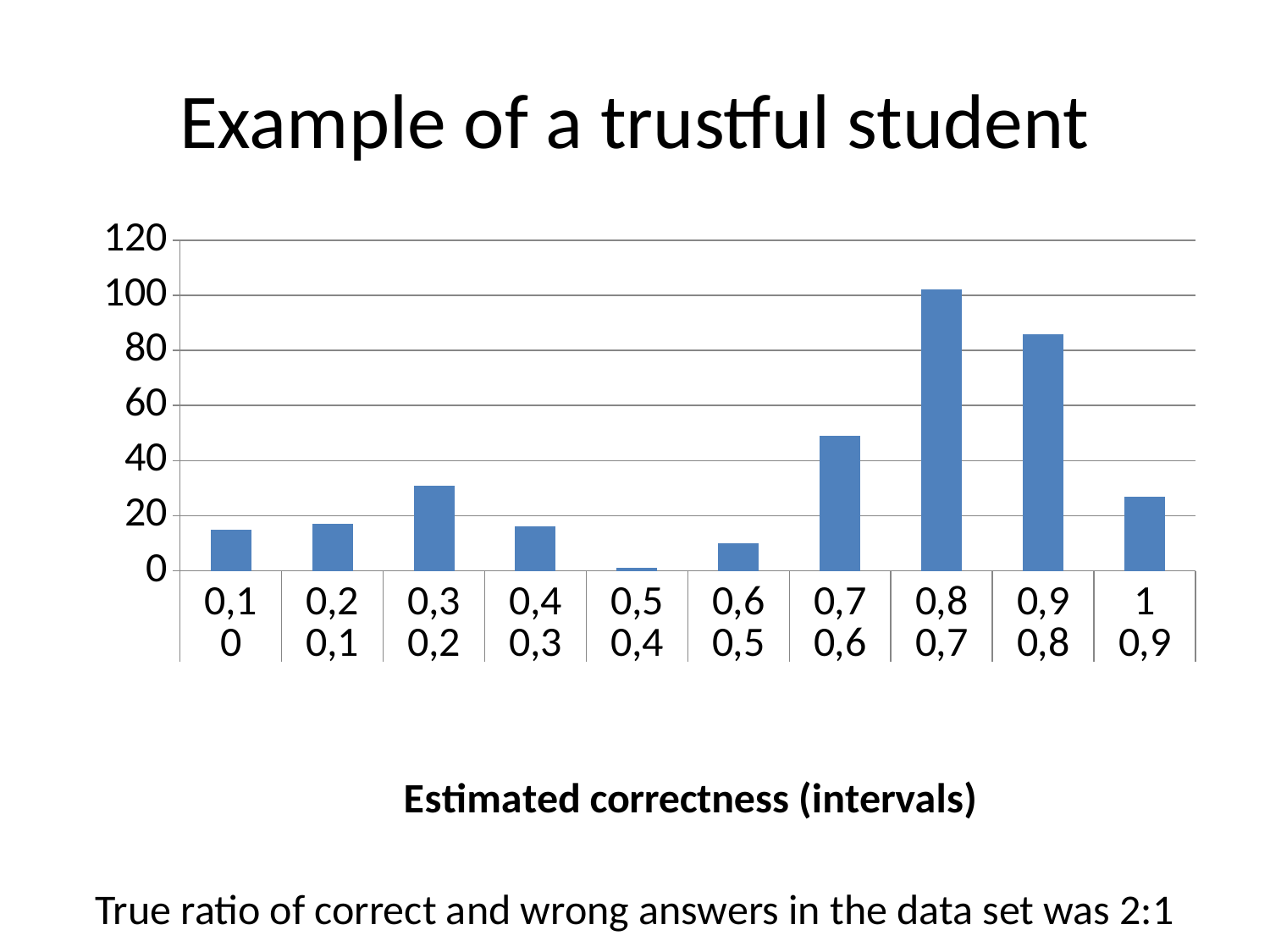
Is the value for the interval labelled 0,7 (0,6) greater or less than 40? greater Is the value for the interval labelled 0,3 (0,2) greater or less than 20? greater Is the value for the interval labelled 1 (0,9) greater or less than 20? greater Which is larger, the bar for the interval 0,7 (0,6) or the bar for the interval 0,3 (0,2)? 0,7 (0,6) Which is larger, the bar for the interval 0,8 (0,7) or the bar for the interval 0,9 (0,8)? 0,8 (0,7) What kind of chart is shown on the slide? bar chart What is the title of the x axis of the chart? Estimated correctness (intervals) Which interval has the lowest bar? 0,5 (0,4) How many intervals (bars) are plotted on the x axis? 10 Which interval has the highest bar? 0,8 (0,7)